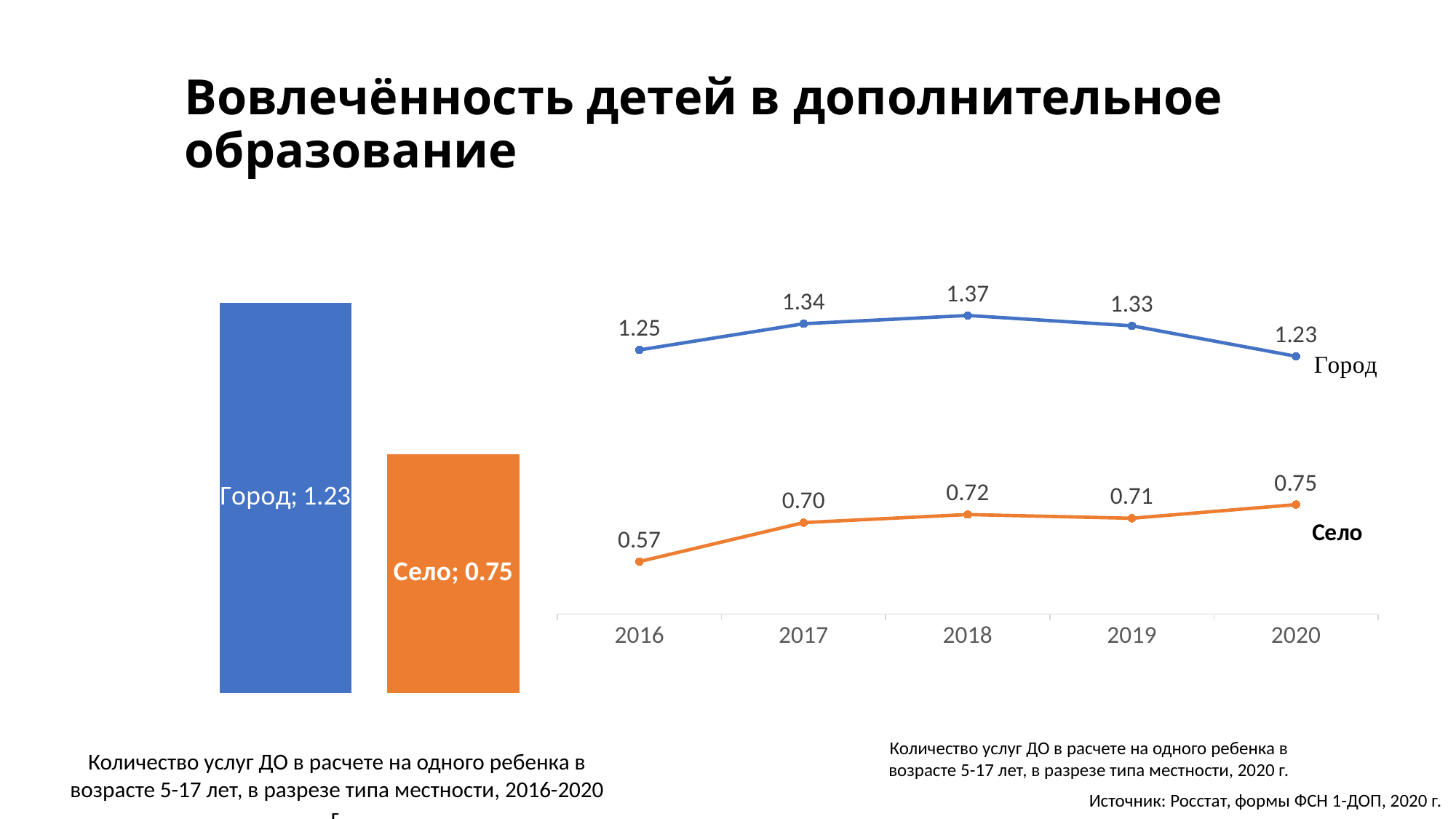
In the line chart on the right, what is the difference between the Город and Село values in 2020? 0.48 In the bar chart on the left, which category has the higher value? Город In the line chart on the right, what is the value for Город in 2018? 1.37 In the bar chart on the left, what is the value for Город? 1.23 In the bar chart on the left, what is the value for Село? 0.75 In the bar chart on the left, what is the difference between the values for Город and Село? 0.48 In the line chart on the right, how many years are shown on the x axis? 5 In the line chart on the right, in which year does the Город series reach its highest value? 2018 In the line chart on the right, in which year is the Село series lowest? 2016 In the line chart on the right, how many series are plotted? 2 In the line chart on the right, what is the value for Село in 2016? 0.57 What kind of chart is shown on the left of the slide? Bar chart